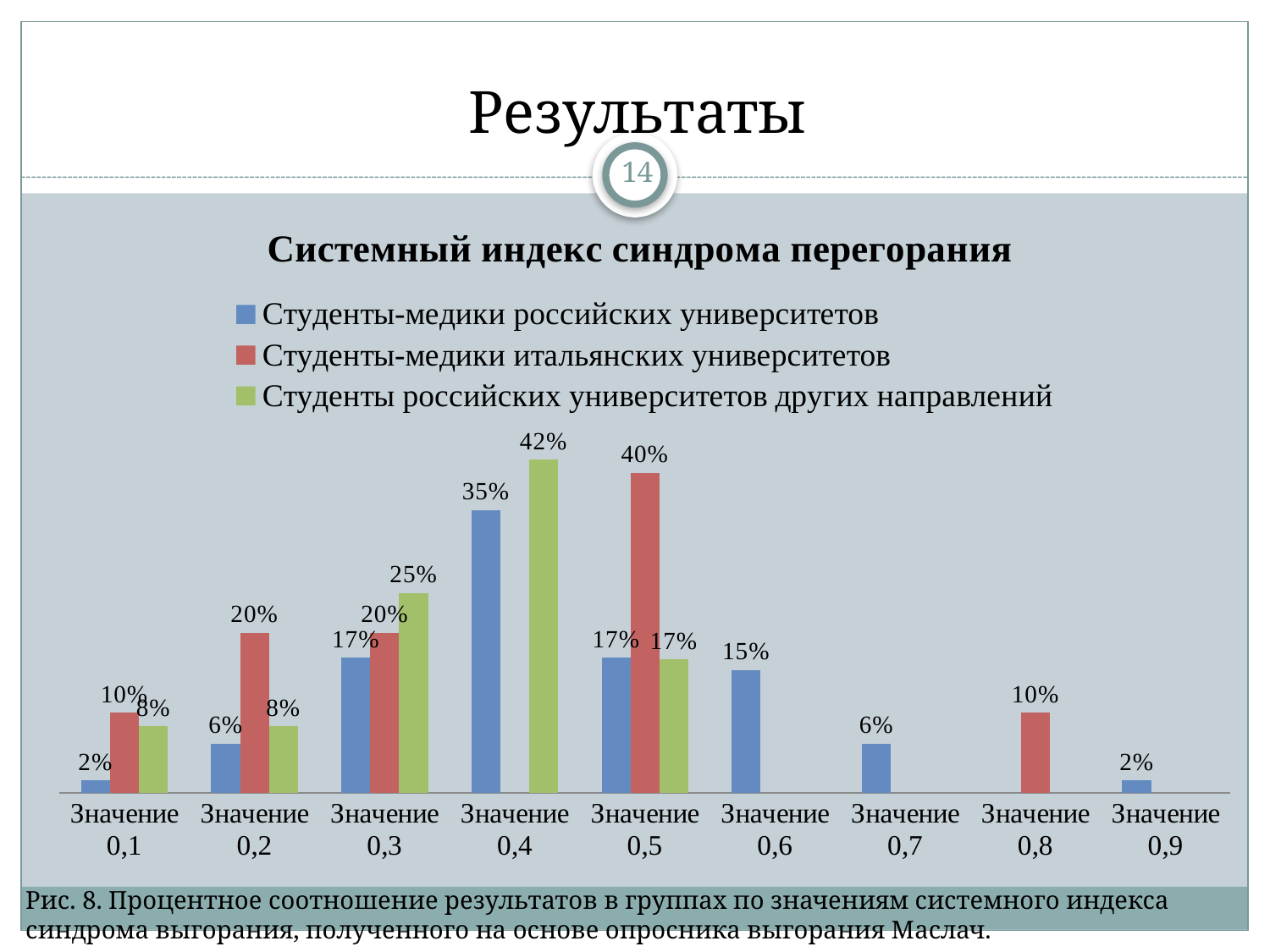
What is the value for Студенты-медики российских университетов at Значение 0,4? 35% What is the value for Студенты российских университетов других направлений at Значение 0,3? 25% What kind of chart is shown on the slide? Bar chart How many categories are shown on the x axis? 9 What is the title of the chart? Системный индекс синдрома перегорания At which category does the series Студенты-медики российских университетов reach its highest value? Значение 0,4 How many series does the legend list? 3 What is the difference between the values for Студенты российских университетов других направлений and Студенты-медики российских университетов at Значение 0,4? 7% What is the value for Студенты-медики итальянских университетов at Значение 0,5? 40% At Значение 0,2, which series has the larger value: Студенты-медики итальянских университетов or Студенты-медики российских университетов? Студенты-медики итальянских университетов At which category does the series Студенты российских университетов других направлений reach its highest value? Значение 0,4 What is the value for Студенты-медики итальянских университетов at Значение 0,8? 10%